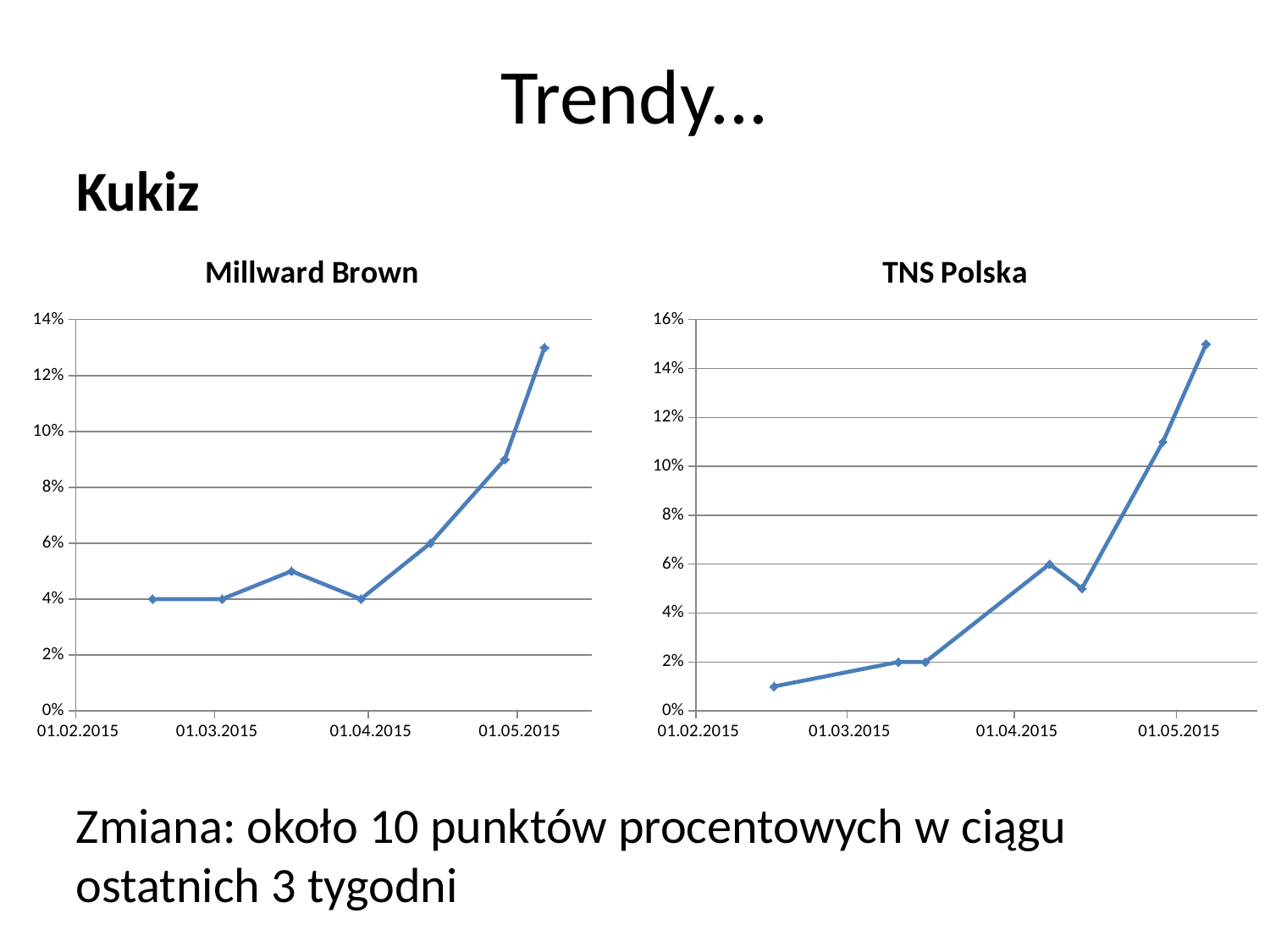
Which chart reaches a higher final value, Millward Brown or TNS Polska? TNS Polska On the Millward Brown chart, do the values generally rise or fall from left to right? rise On the Millward Brown chart, what is the lowest value on the line? 4% What type of chart is the TNS Polska chart? line chart What type of chart is the Millward Brown chart? line chart On the TNS Polska chart, is the last plotted value greater or less than 14%? greater What is the title of the chart on the right side of the slide? TNS Polska How many data points are plotted on the Millward Brown chart? 7 How many data points are plotted on the TNS Polska chart? 7